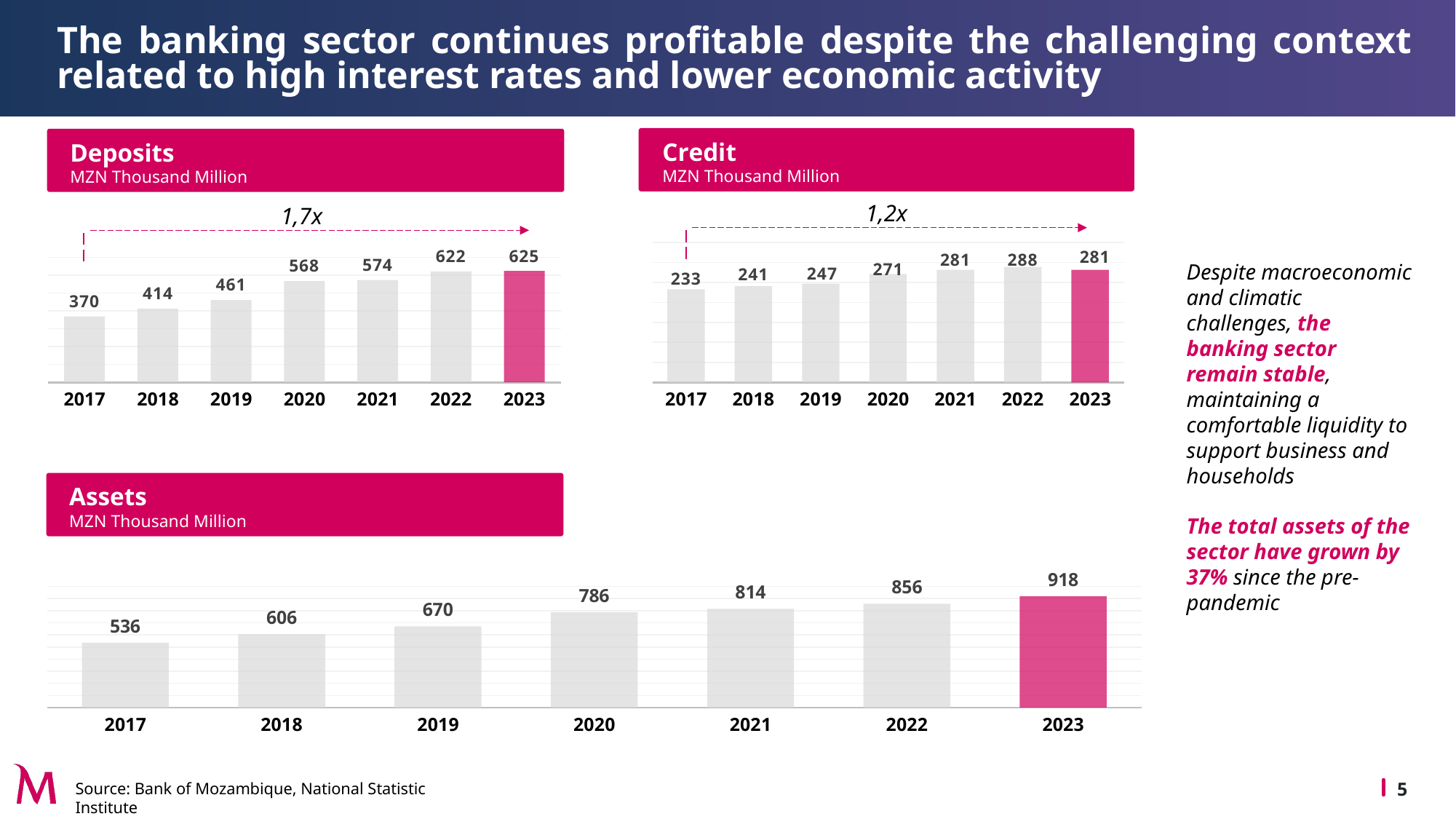
In the Credit chart, which year has the lowest value? 2017 In the Assets chart, what is the value for 2021? 814 In the Credit chart, what is the value for 2020? 271 In the Credit chart, what is the difference between the 2022 and 2023 values? 7 In the Assets chart, do the values rise or fall from 2017 to 2023? rise In the Deposits chart, which bar is coloured pink rather than grey? 2023 How many years are shown on the x axis of the Assets chart? 7 In the Deposits chart, what is the difference between the 2023 and 2017 values? 255 What kind of chart is the Deposits chart? bar chart In the Deposits chart, which year has the highest value? 2023 In the Assets chart, which year has the highest value? 2023 In the Deposits chart, what is the value for 2017? 370